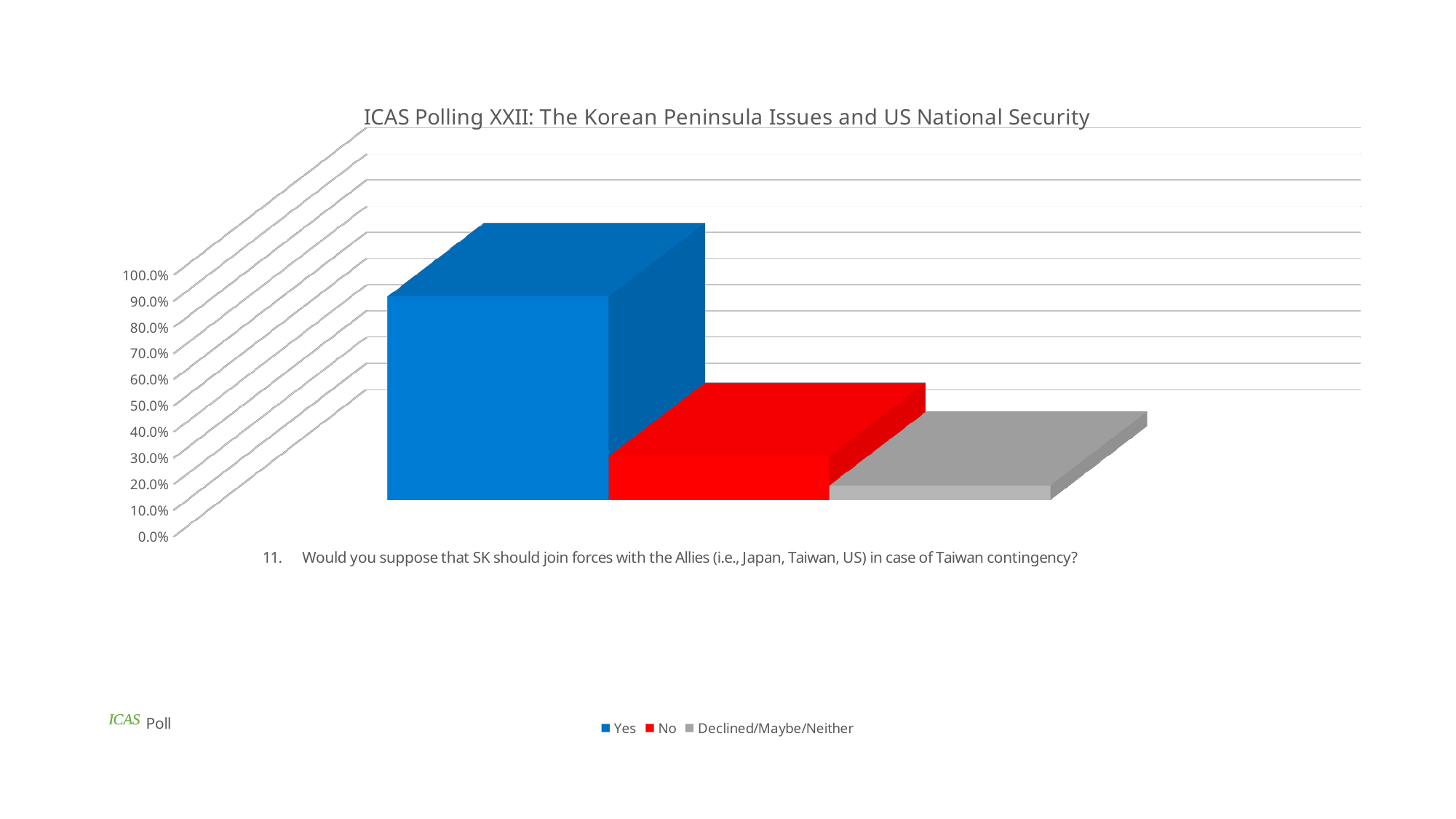
Which response has the highest value? Yes Which is larger, the value for Yes or the value for No? Yes Which response has the lowest value? Declined/Maybe/Neither Is the value for Yes greater or less than 50.0%? greater Is the value for No greater or less than 30.0%? less Which is larger, the value for No or the value for Declined/Maybe/Neither? No What colour represents the No series in the legend? red How many poll questions (categories) are plotted on the x axis? 1 Is the value for Declined/Maybe/Neither greater or less than 20.0%? less What kind of chart is shown on the slide? bar chart What is the title of the chart? ICAS Polling XXII: The Korean Peninsula Issues and US National Security How many series does the legend list? 3